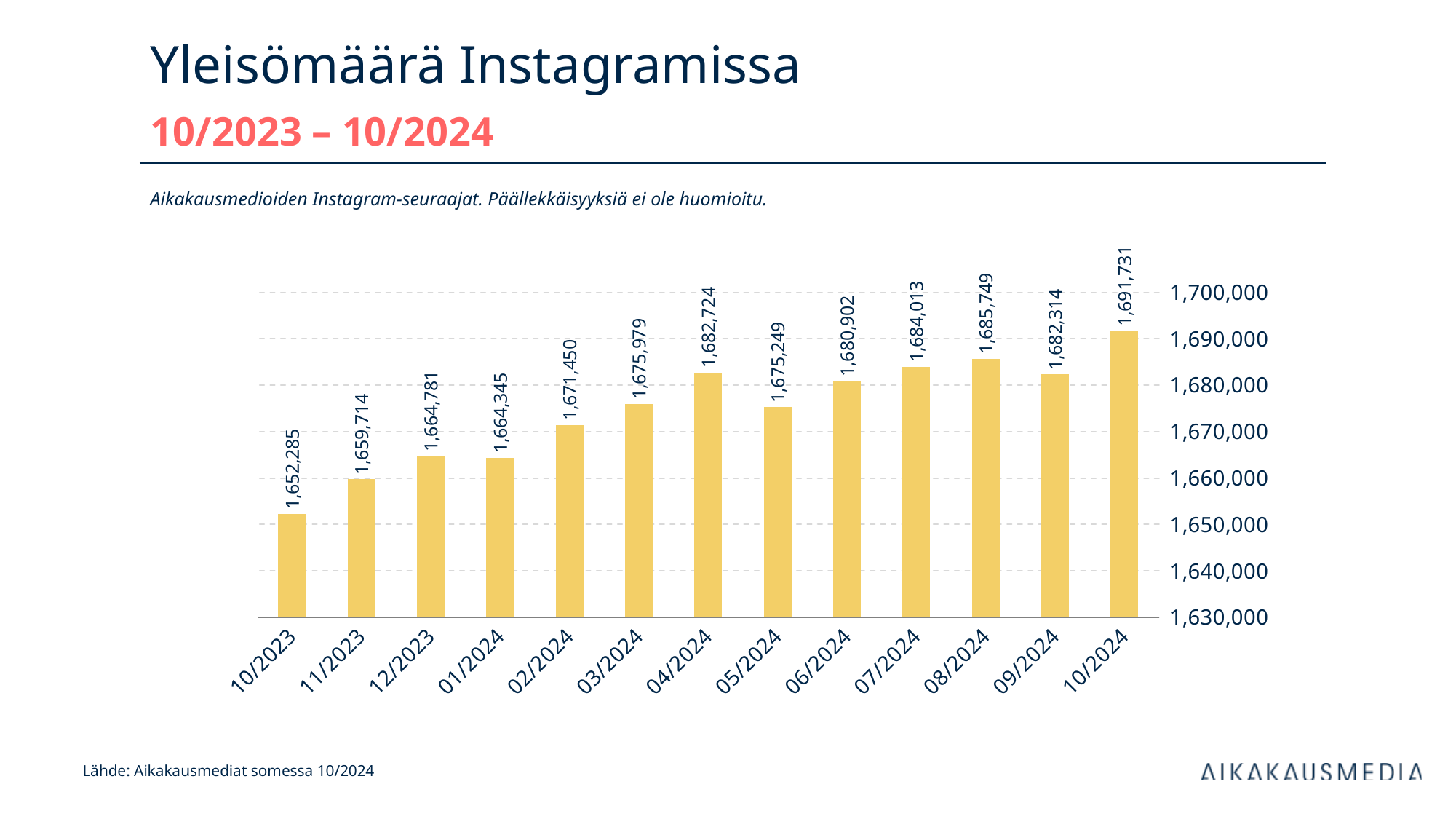
Which month has the lowest value? 10/2023 Which month has the highest value? 10/2024 What kind of chart is shown on the slide? bar chart Is the value for 02/2024 greater or less than 1,680,000? less How many months are shown on the chart? 13 What is the difference between the values for 10/2024 and 10/2023? 39,446 What is the value for 10/2023? 1,652,285 What is the value for 10/2024? 1,691,731 What is the title of the slide? Yleisömäärä Instagramissa What is the difference between the values for 04/2024 and 05/2024? 7,475 Which is larger, the value for 08/2024 or the value for 09/2024? 08/2024 What is the value for 04/2024? 1,682,724